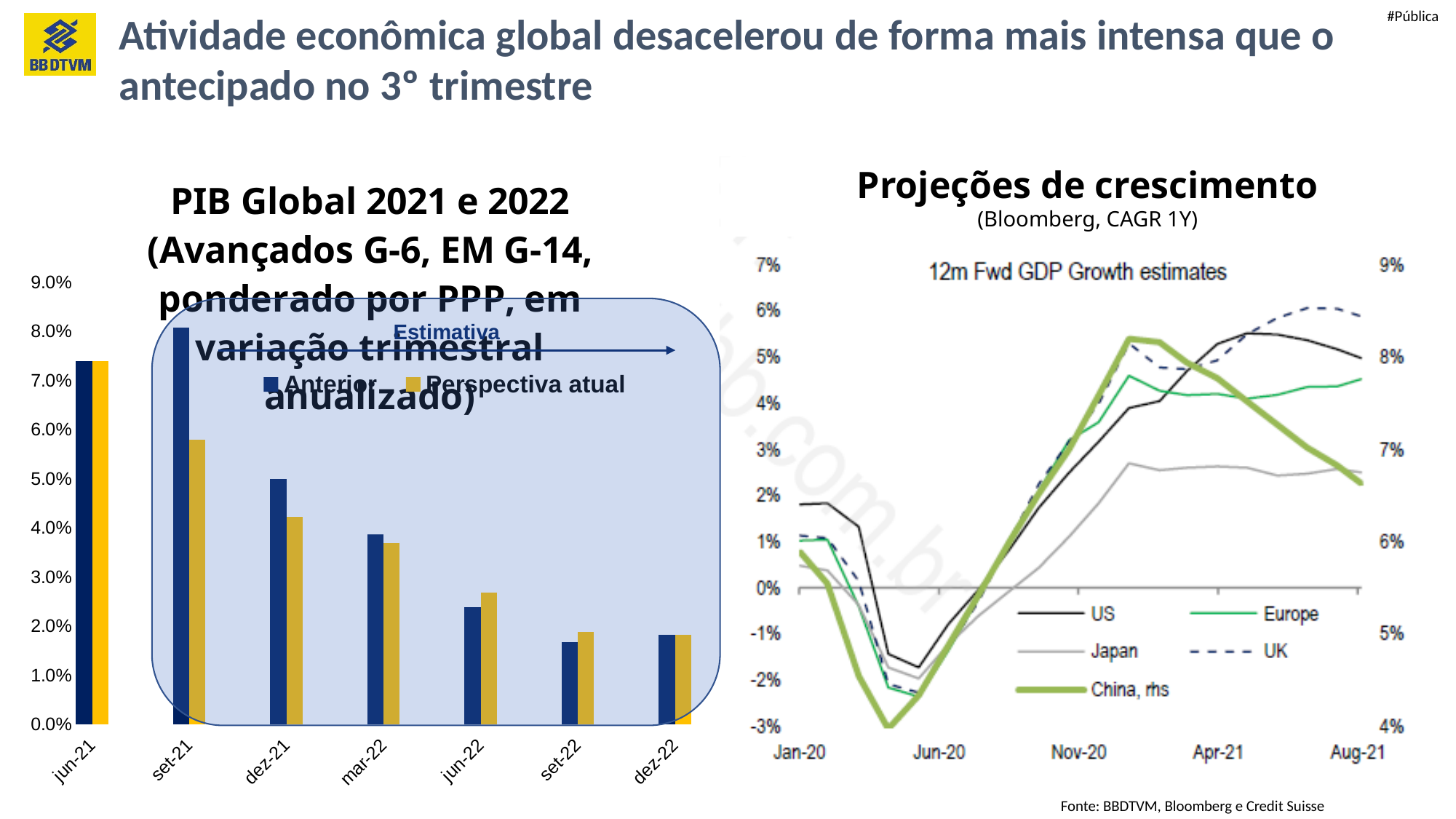
In the left bar chart, is the 'Anterior' value for set-21 greater or less than 7.0%? greater In the left bar chart, is the 'Anterior' value for jun-22 greater or less than 3.0%? less In the left bar chart, do the 'Anterior' values rise or fall from set-21 to dez-22? fall How many series does the legend of the left bar chart list? 2 How many categories are shown on the x axis of the left bar chart? 7 How many series does the legend of the right line chart list? 5 In the left bar chart, is the 'Perspectiva atual' value for dez-21 greater or less than 5.0%? less What kind of chart is the right chart, 'Projeções de crescimento'? line chart In the left bar chart, which category has the highest 'Anterior' value? set-21 In the left bar chart, for set-21, which is larger: 'Anterior' or 'Perspectiva atual'? Anterior What kind of chart is the left chart, 'PIB Global 2021 e 2022'? bar chart